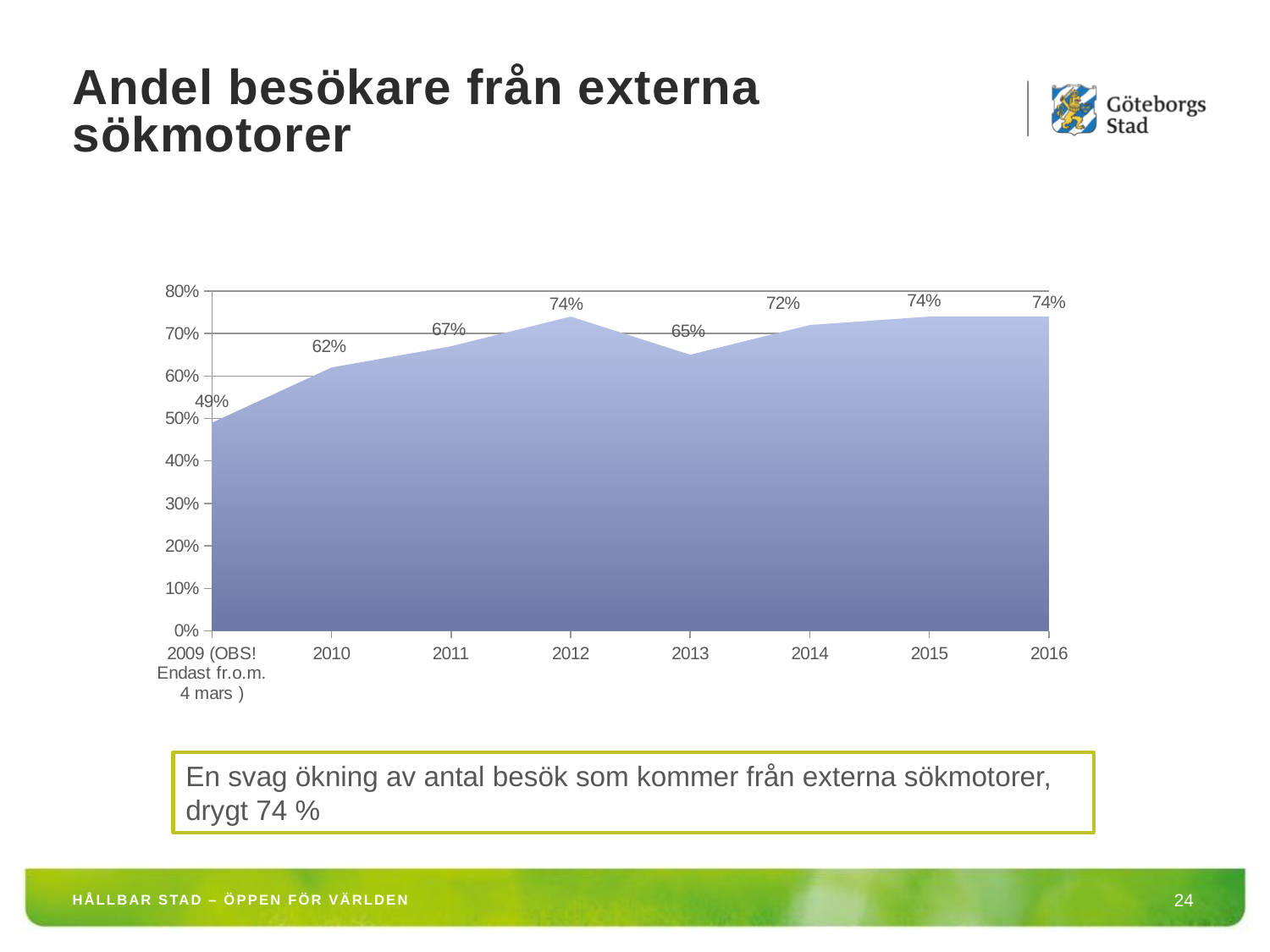
What is the value for 2016? 74% Which is larger, the value for 2011 or the value for 2013? 2011 What is the difference between the values for 2012 and 2013? 9% Does the value rise or fall from 2009 to 2012? Rise What is the value for 2010? 62% How many years are plotted in the chart? 8 What is the highest value shown in the chart? 74% What is the value for 2013? 65% What kind of chart is shown on the slide? Area chart Which year has the lowest value? 2009 What is the difference between the values for 2016 and 2009? 25% What is the value for 2014? 72%